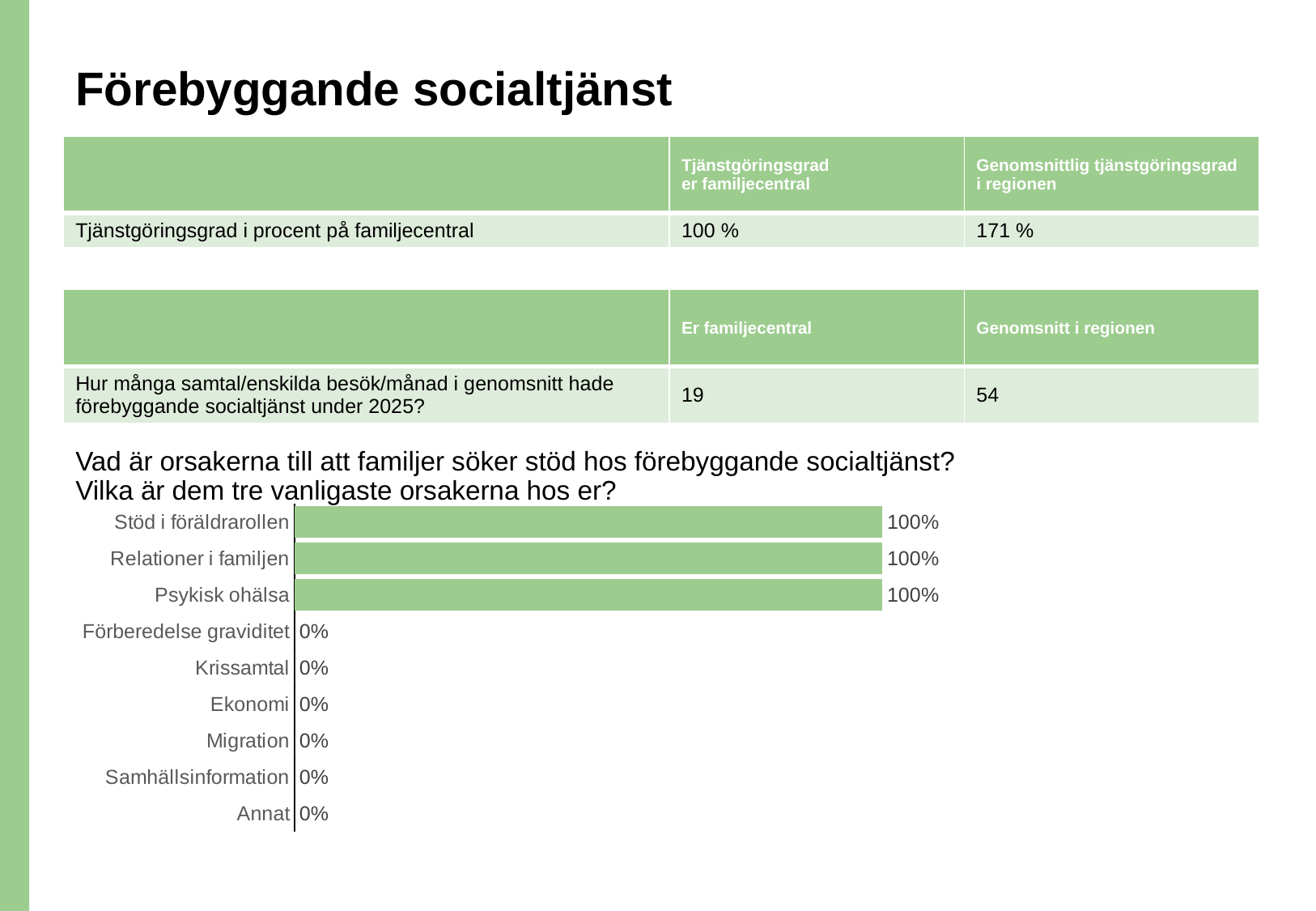
What is the value for Relationer i familjen in the bar chart? 100% What colour are the bars in the chart? Green Which is larger in the bar chart, the value for Relationer i familjen or the value for Krissamtal? Relationer i familjen What is the difference between the value for Psykisk ohälsa and the value for Annat in the bar chart? 100% Which category is listed first (at the top) in the bar chart? Stöd i föräldrarollen How many categories in the bar chart have a value of 100%? 3 What is the value for Ekonomi in the bar chart? 0% What is the value for Stöd i föräldrarollen in the bar chart? 100% How many categories are shown in the bar chart? 9 What is the value for Psykisk ohälsa in the bar chart? 100% What kind of chart is shown on the slide? Bar chart What is the value for Migration in the bar chart? 0%